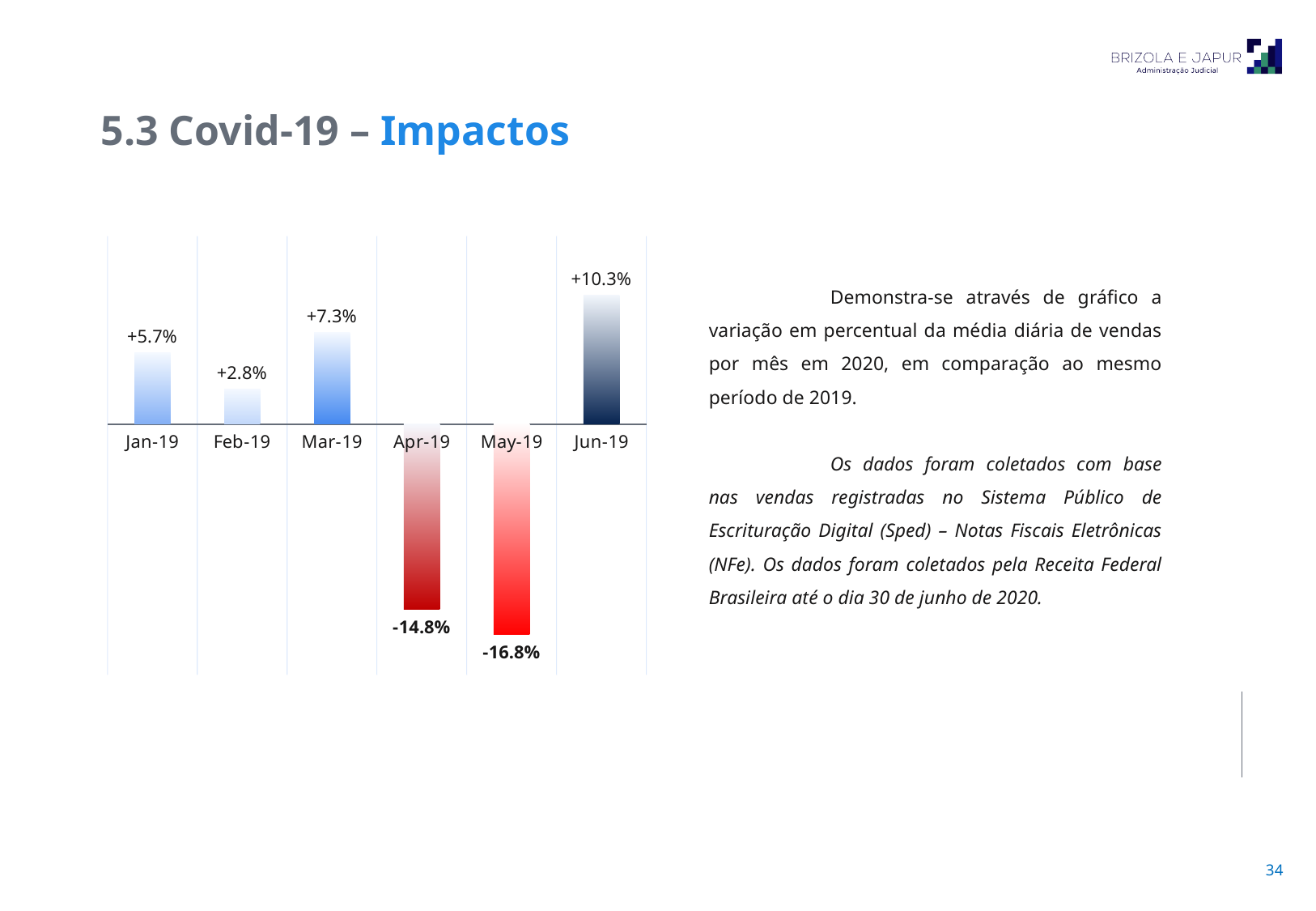
How many months show a negative value? 2 Which is larger, the value for Mar-19 or the value for Jan-19? Mar-19 Which month has the lowest value? May-19 What is the value shown for Feb-19? +2.8% How many months are shown on the chart? 6 What is the value shown for Apr-19? -14.8% What is the difference between the values for Jun-19 and Mar-19? 3.0% What kind of chart is shown on the slide? Bar chart Which month has the highest value? Jun-19 What colour are the bars for the months with negative values? Red What is the value shown for Jun-19? +10.3% What is the value shown for Jan-19? +5.7%